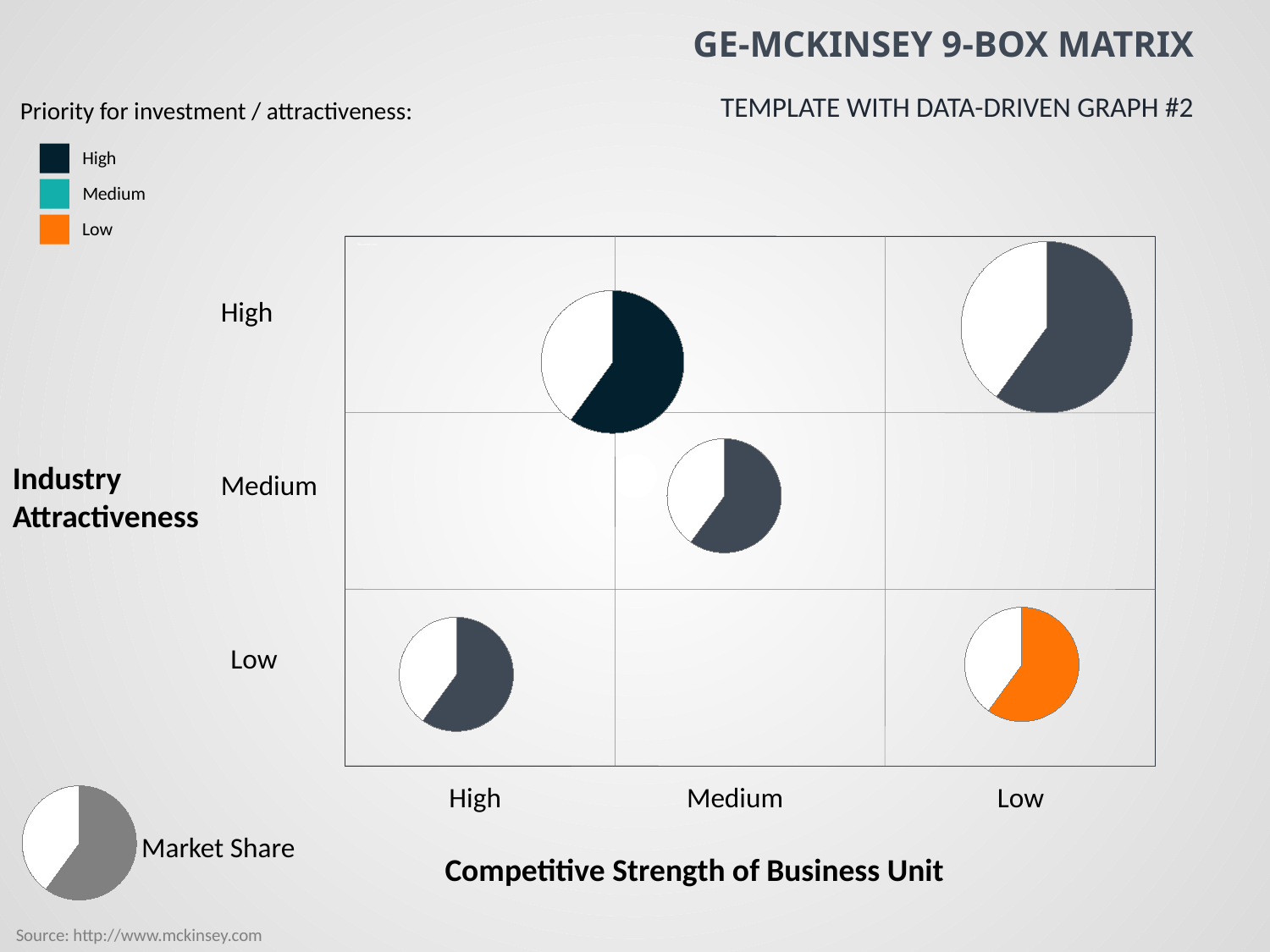
In which cell of the matrix is the dark navy (High priority) bubble located? High industry attractiveness, Medium competitive strength What kind of chart is used to plot the business units in the matrix? Pie charts Which priority level does the bubble in the Low attractiveness / Low competitive strength cell represent, according to the legend colour? Low How many bubbles are plotted in the High competitive strength column? 1 How many bubbles are plotted in the 9-box matrix? 5 How many priority levels does the legend for investment priority / attractiveness list? 3 How many bubbles are plotted in the High industry attractiveness row? 2 Is the bubble in the High attractiveness / Low competitive strength cell larger or smaller than the bubble in the Medium attractiveness / Medium competitive strength cell? Larger In which cell of the matrix is the orange (Low priority) bubble located? Low industry attractiveness, Low competitive strength Which cell of the matrix contains the largest bubble? High industry attractiveness, Low competitive strength What is the title of the chart on the slide? GE-McKinsey 9-Box Matrix What is the label of the horizontal axis of the matrix? Competitive Strength of Business Unit